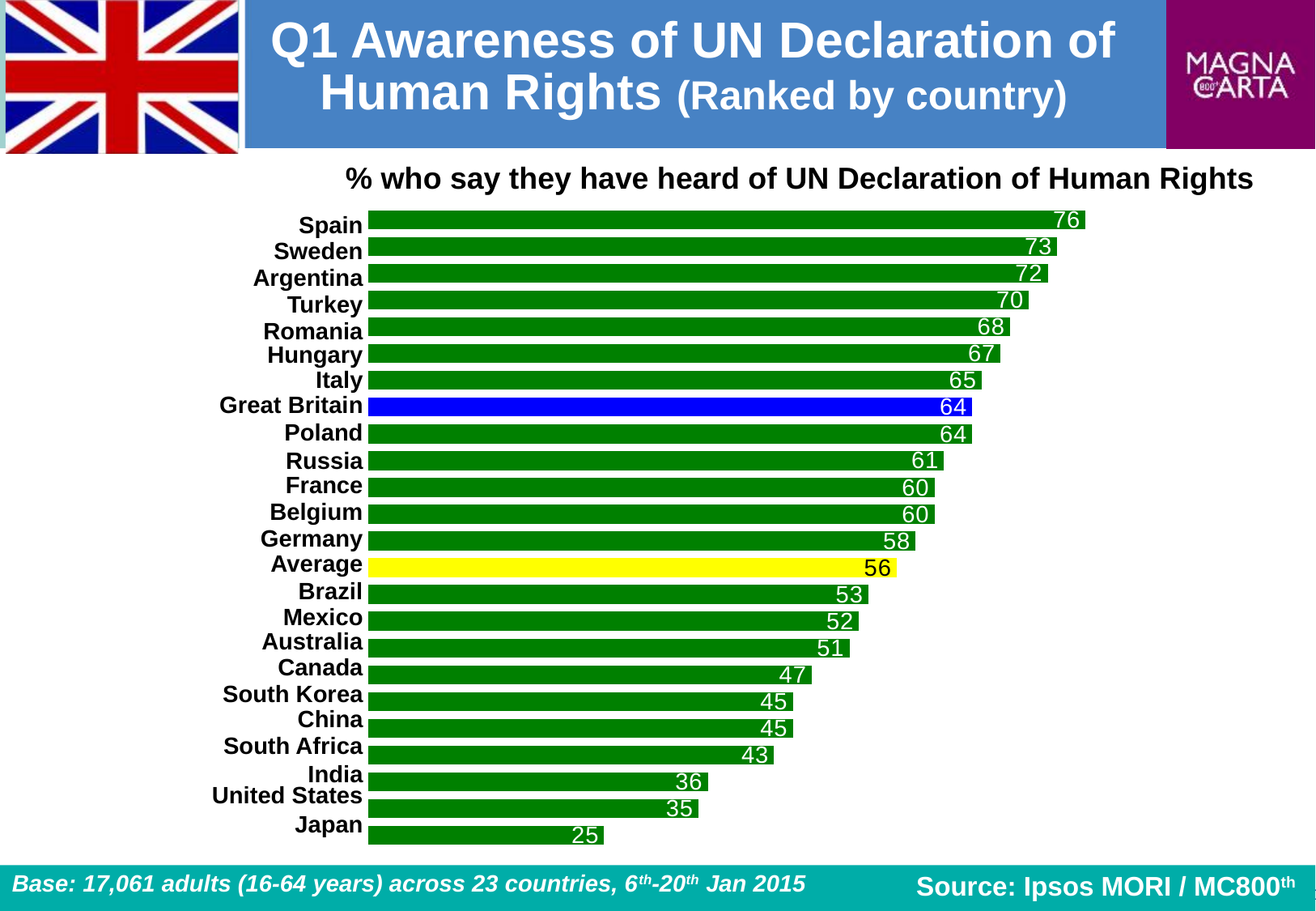
Which country has the highest value? Spain What is the value shown for the Average bar? 56 What is the value for Japan? 25 How many bars are plotted in the chart, including the Average bar? 24 What kind of chart is shown on the slide? Bar chart Which bar is coloured blue? Great Britain What is the difference between the values for Great Britain and the Average? 8 What is the difference between the values for Spain and Japan? 51 What is the value for Great Britain? 64 Which has a larger value, Canada or Brazil? Brazil Which country has the lowest value? Japan What is the value for Spain? 76